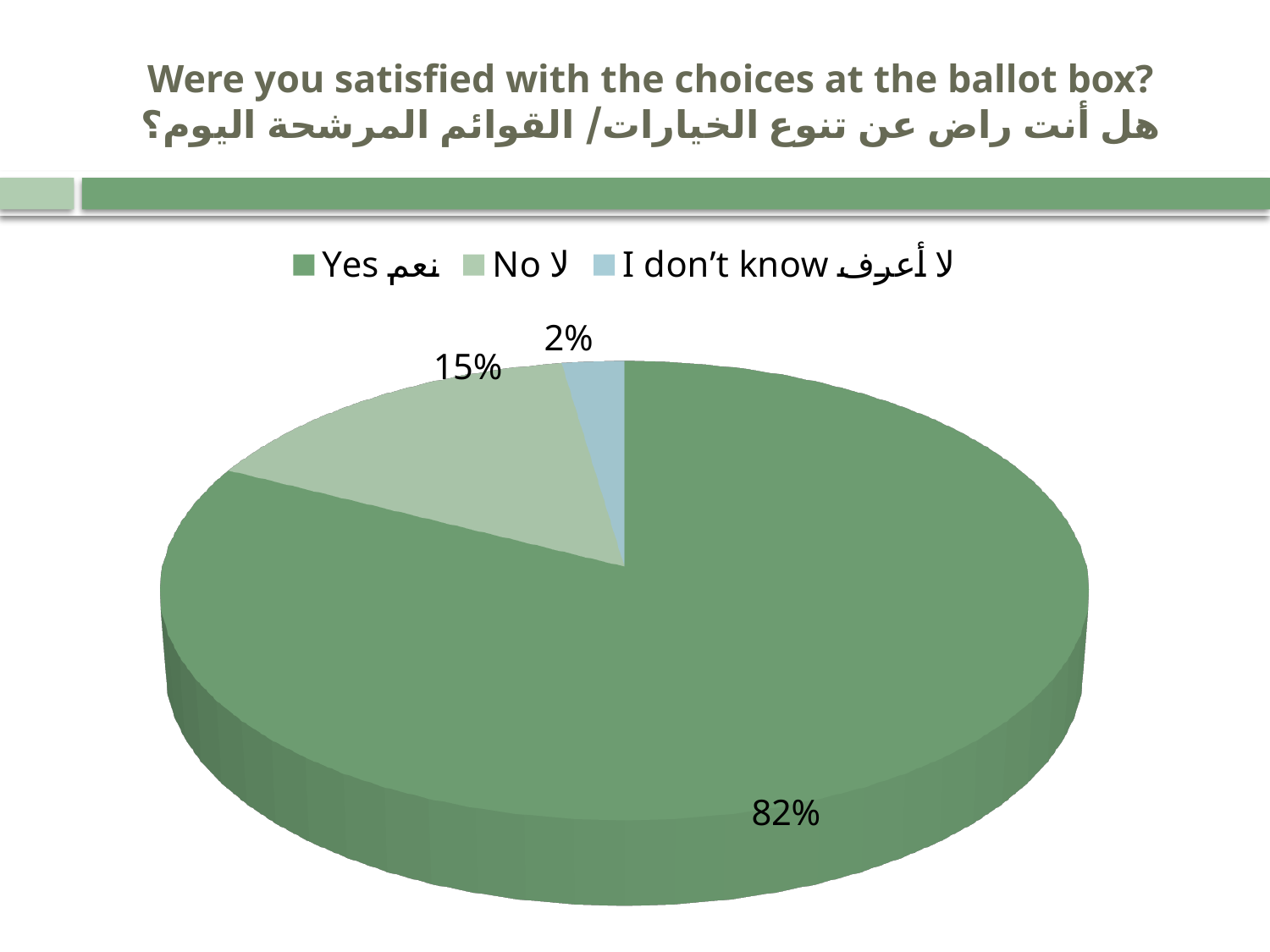
What is the difference in percentage points between the "No" and "I don't know" slices? 13 What is the difference in percentage points between the "Yes" and "No" slices? 67 What kind of chart is shown on the slide? pie chart What percentage of respondents answered "No"? 15% What percentage of respondents answered "Yes"? 82% Which is larger, the "No" slice or the "I don't know" slice? No How many entries does the legend list? 3 Which response has the smallest share of the pie? I don't know How many slices does the pie chart have? 3 What percentage of respondents answered "I don't know"? 2% Which response has the largest share of the pie? Yes What question does the chart title ask? Were you satisfied with the choices at the ballot box?